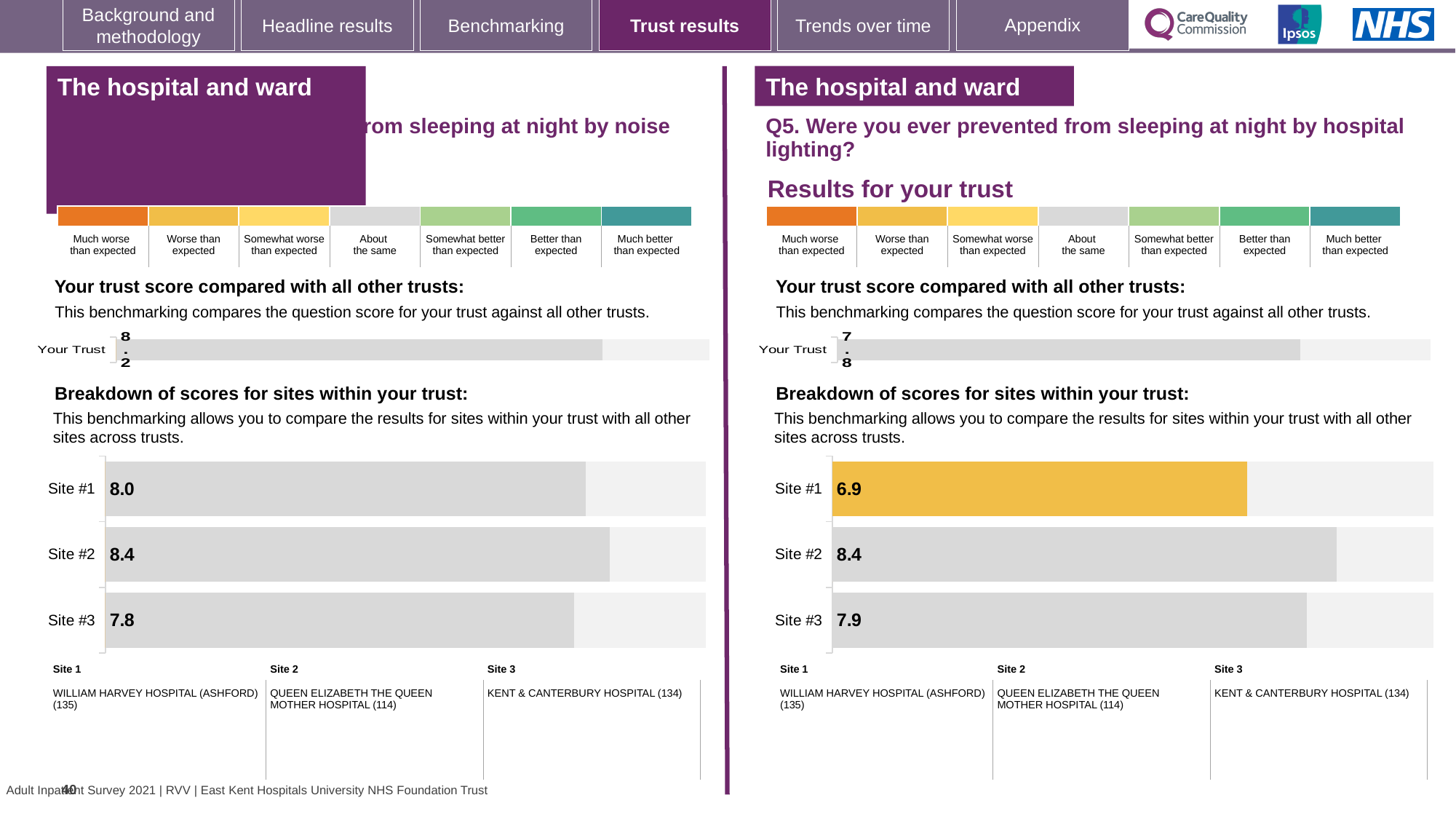
On the right-hand chart (Q5, hospital lighting), what is the difference between the Site #2 and Site #1 scores? 1.5 On the right-hand chart (Q5, hospital lighting), what is the score for Site #2? 8.4 How many sites are shown in the site breakdown chart on the right-hand side (Q5, hospital lighting)? 3 On the right-hand chart (Q5, hospital lighting), what is the score for Site #1? 6.9 On the left-hand chart (sleeping at night by noise), which site has the highest score? Site #2 On the left-hand chart (sleeping at night by noise), what is the difference between the Site #2 and Site #3 scores? 0.6 On the left-hand chart (sleeping at night by noise), what is the score for Site #3? 7.8 What type of chart is used for the breakdown of scores for sites on the right-hand side (Q5, hospital lighting)? Bar chart On the right-hand chart (Q5, hospital lighting), which site has the lowest score? Site #1 On the right-hand chart (Q5, hospital lighting), what is the score for Site #3? 7.9 On the left-hand chart (sleeping at night by noise), what is the score for Site #1? 8.0 On the right-hand chart (Q5, hospital lighting), which is larger, the score for Site #3 or Site #1? Site #3